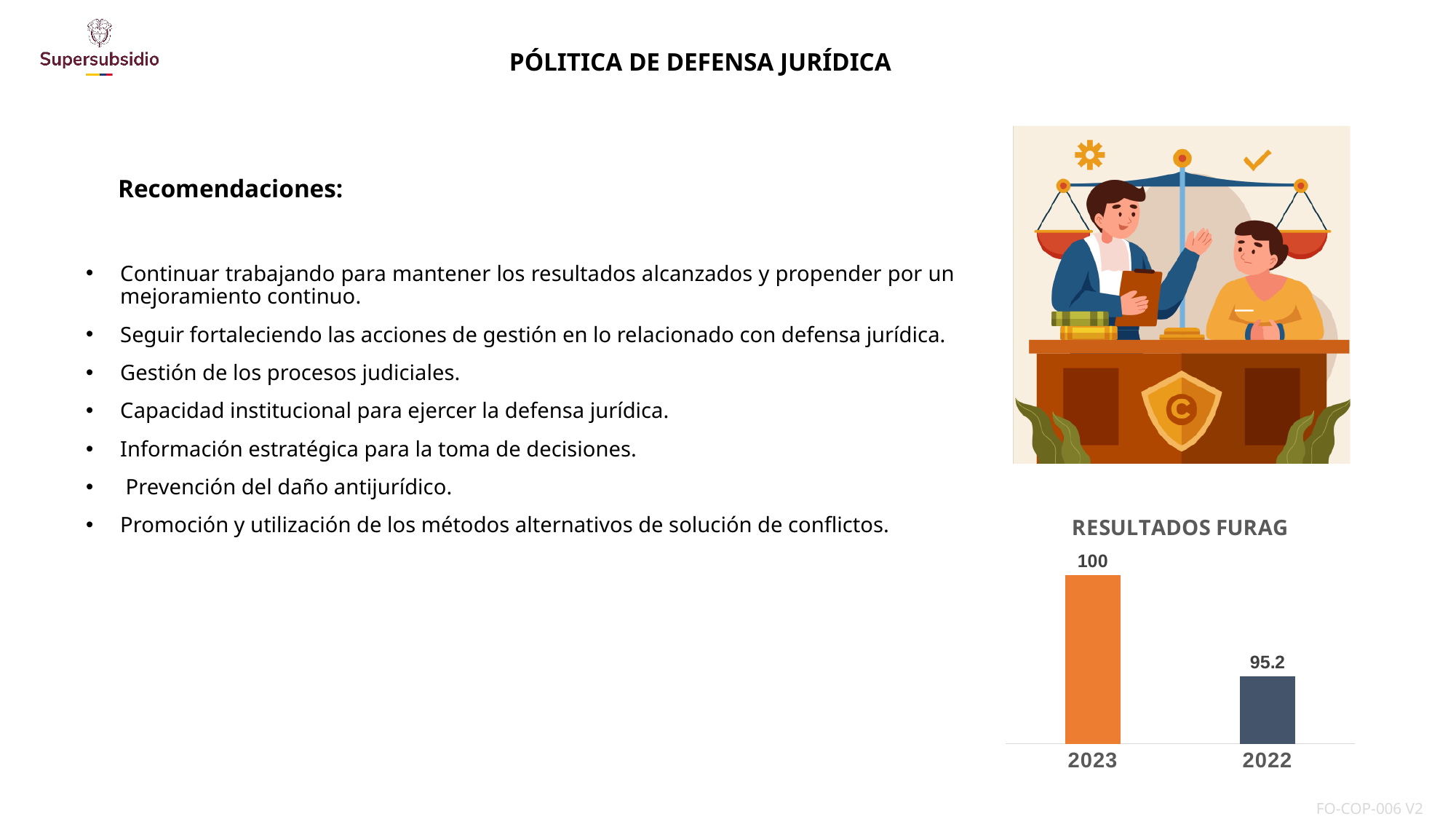
In the RESULTADOS FURAG chart, is the value for 2023 or 2022 larger? 2023 What type of chart is RESULTADOS FURAG? Bar chart Which year has the lowest value in the RESULTADOS FURAG chart? 2022 What is the value for 2022 in the RESULTADOS FURAG chart? 95.2 Which year has the highest value in the RESULTADOS FURAG chart? 2023 What colour is the bar for 2023 in the RESULTADOS FURAG chart? Orange How many bars are shown in the RESULTADOS FURAG chart? 2 What is the title of the chart on the slide? RESULTADOS FURAG What is the value for 2023 in the RESULTADOS FURAG chart? 100 What is the difference between the 2023 and 2022 values in the RESULTADOS FURAG chart? 4.8